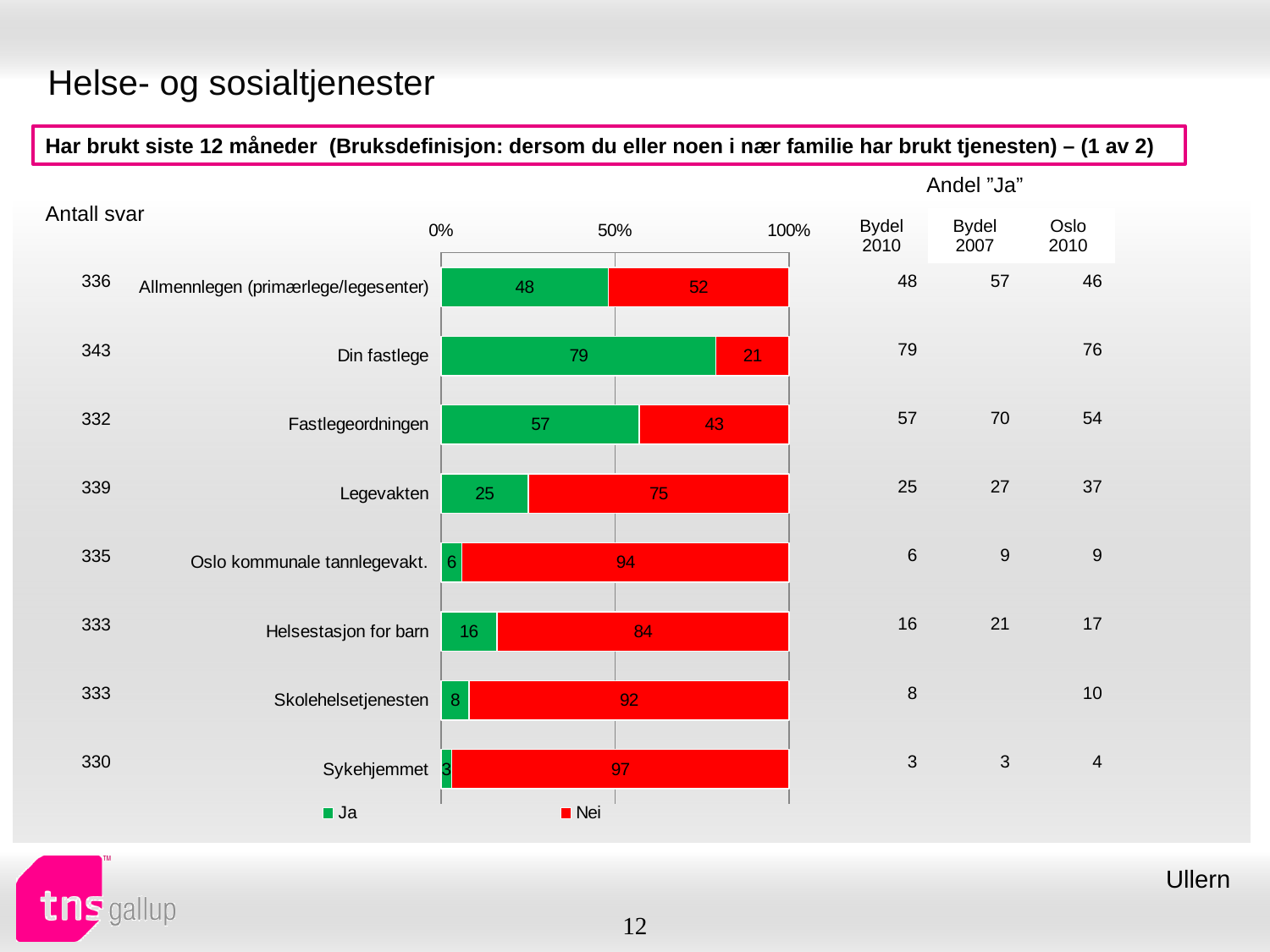
What is the "Ja" value for Helsestasjon for barn? 16 What is the total of the stacked bar for Skolehelsetjenesten? 100 What kind of chart is shown on the slide? Stacked bar chart Which colour represents the "Nei" series in the chart? Red How many series does the legend list? 2 Which category has the highest "Ja" value? Din fastlege What is the "Ja" value for Din fastlege? 79 What is the "Nei" value for Legevakten? 75 Which category has the lowest "Ja" value? Sykehjemmet Which is larger, the "Ja" value for Allmennlegen (primærlege/legesenter) or the "Ja" value for Legevakten? Allmennlegen (primærlege/legesenter) How many categories are shown in the chart? 8 What is the difference between the "Ja" values for Din fastlege and Fastlegeordningen? 22